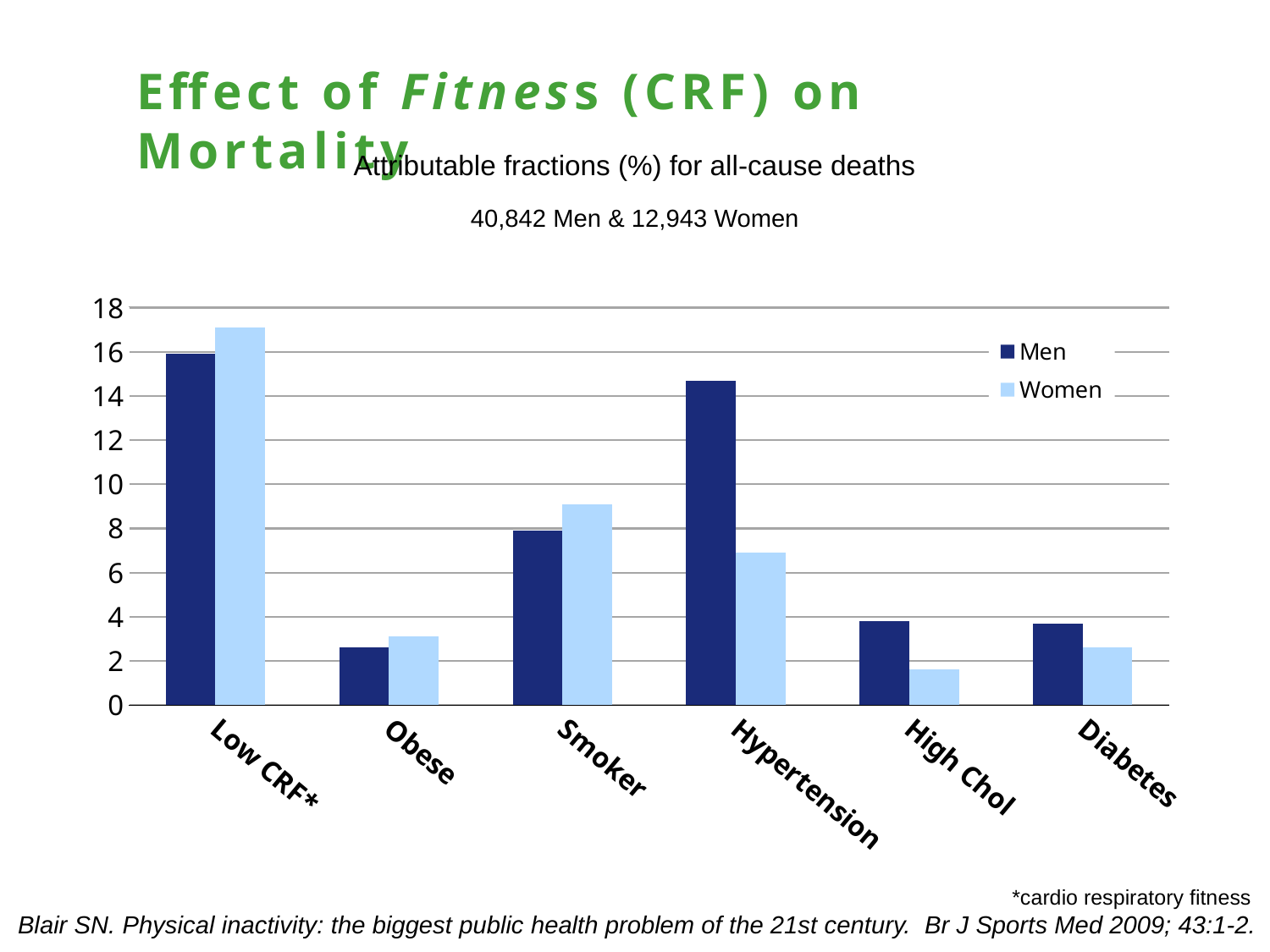
What kind of chart is shown on the slide? bar chart How many series does the legend list? 2 Is the value for Women in the High Chol category greater or less than 2? less How many risk-factor categories are shown on the x axis? 6 Which category has the highest value for Men? Low CRF* What colour are the bars for the Women series? light blue For Smoker, which is larger, the value for Men or for Women? Women Is the value for Men in the Hypertension category greater or less than 12? greater Which category has the lowest value for Women? High Chol For Hypertension, which is larger, the value for Men or for Women? Men Is the value for Women in the Low CRF* category greater or less than 16? greater Which category has the highest value for Women? Low CRF*